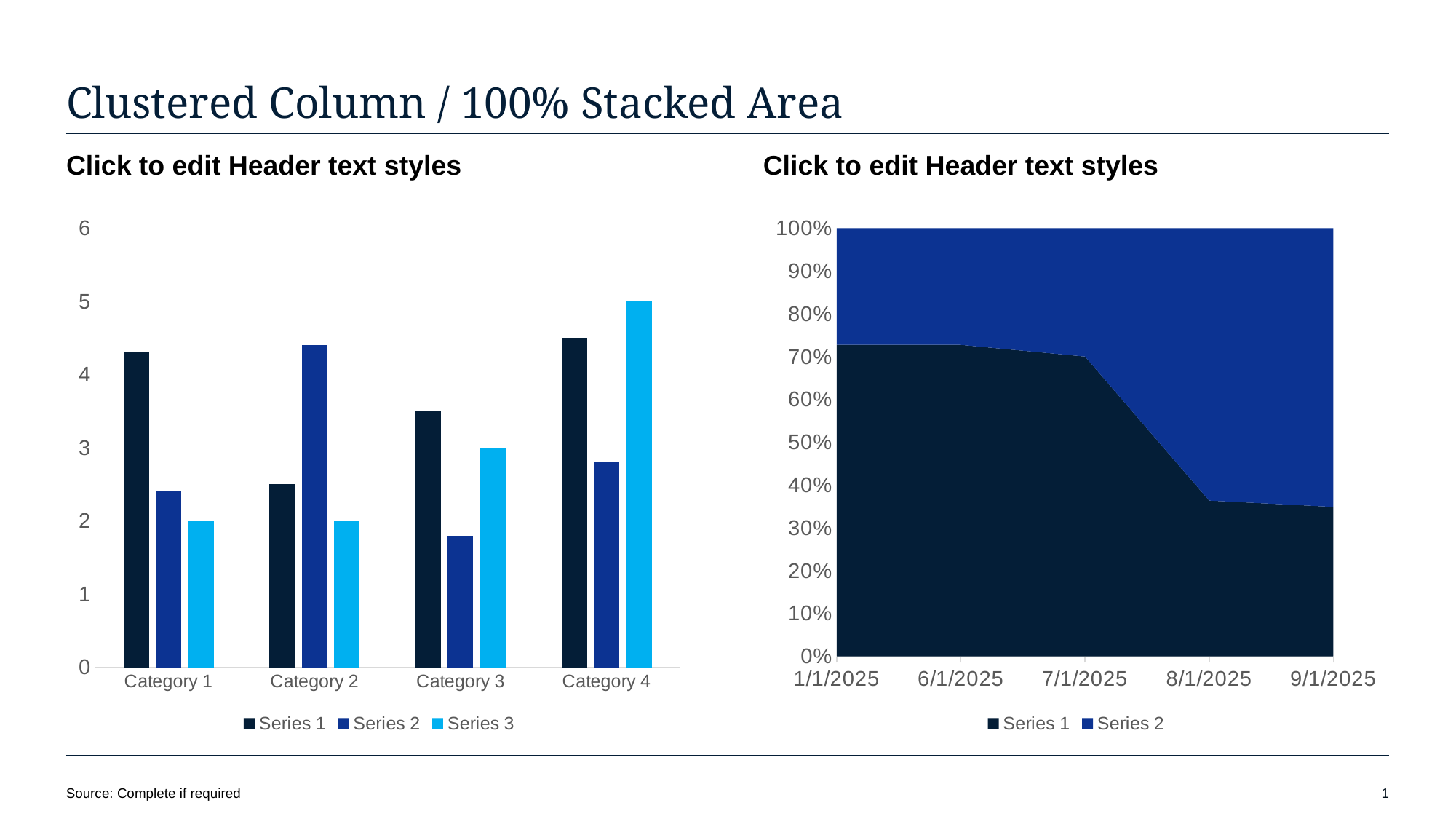
What kind of chart is the chart on the left side of the slide? bar chart In the left chart, what is the value of Series 3 for Category 4? 5 In the right chart, does the share of Series 1 rise or fall from 1/1/2025 to 9/1/2025? fall In the left chart, which category has the highest Series 3 value? Category 4 In the left chart, which is larger for Category 2: Series 1 or Series 2? Series 2 In the left chart, how many categories are shown on the x axis? 4 In the right chart, how many series does the legend list? 2 In the left chart, which category has the lowest Series 2 value? Category 3 In the left chart, what is the value of Series 3 for Category 3? 3 What kind of chart is the chart on the right side of the slide? 100% stacked area chart In the left chart, is the value of Series 1 for Category 1 greater or less than 4? greater In the left chart, how many series does the legend list? 3